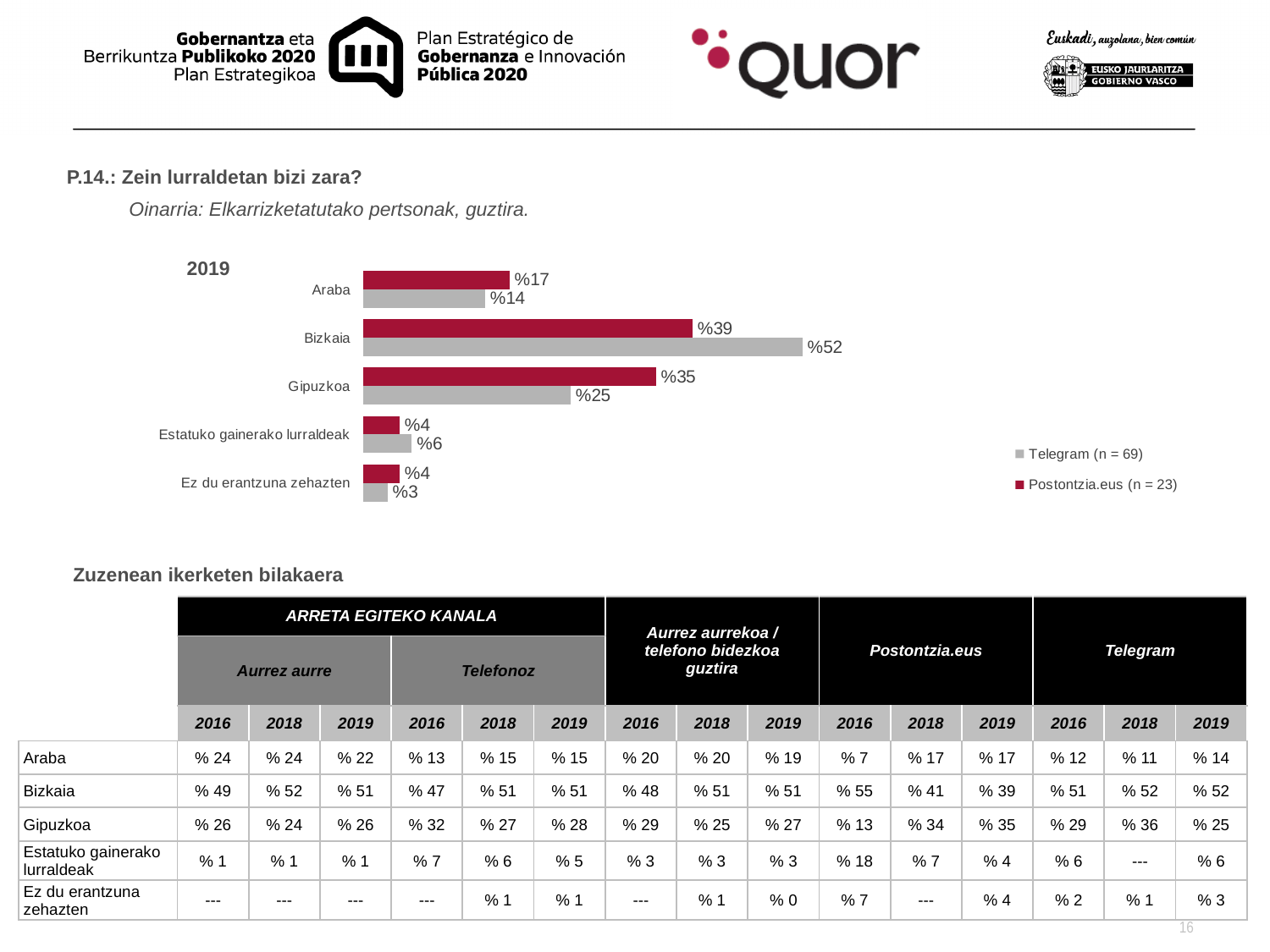
What is the sample size (n) for Postontzia.eus shown in the chart legend? 23 How many series does the legend of the 2019 chart list? 2 What is the Postontzia.eus value for Gipuzkoa in the 2019 chart? %35 What is the difference between the Telegram and Postontzia.eus values for Bizkaia in the 2019 chart? 13 percentage points How many categories are shown in the 2019 chart? 5 What is the Postontzia.eus value for Araba in the 2019 chart? %17 What is the Telegram value for Bizkaia in the 2019 chart? %52 Which category has the lowest Telegram value in the 2019 chart? Ez du erantzuna zehazten In the 2019 chart, which is larger for Gipuzkoa: the Telegram value or the Postontzia.eus value? Postontzia.eus Which category has the highest Telegram value in the 2019 chart? Bizkaia What kind of chart is shown on the slide? Bar chart What is the Telegram value for Estatuko gainerako lurraldeak in the 2019 chart? %6